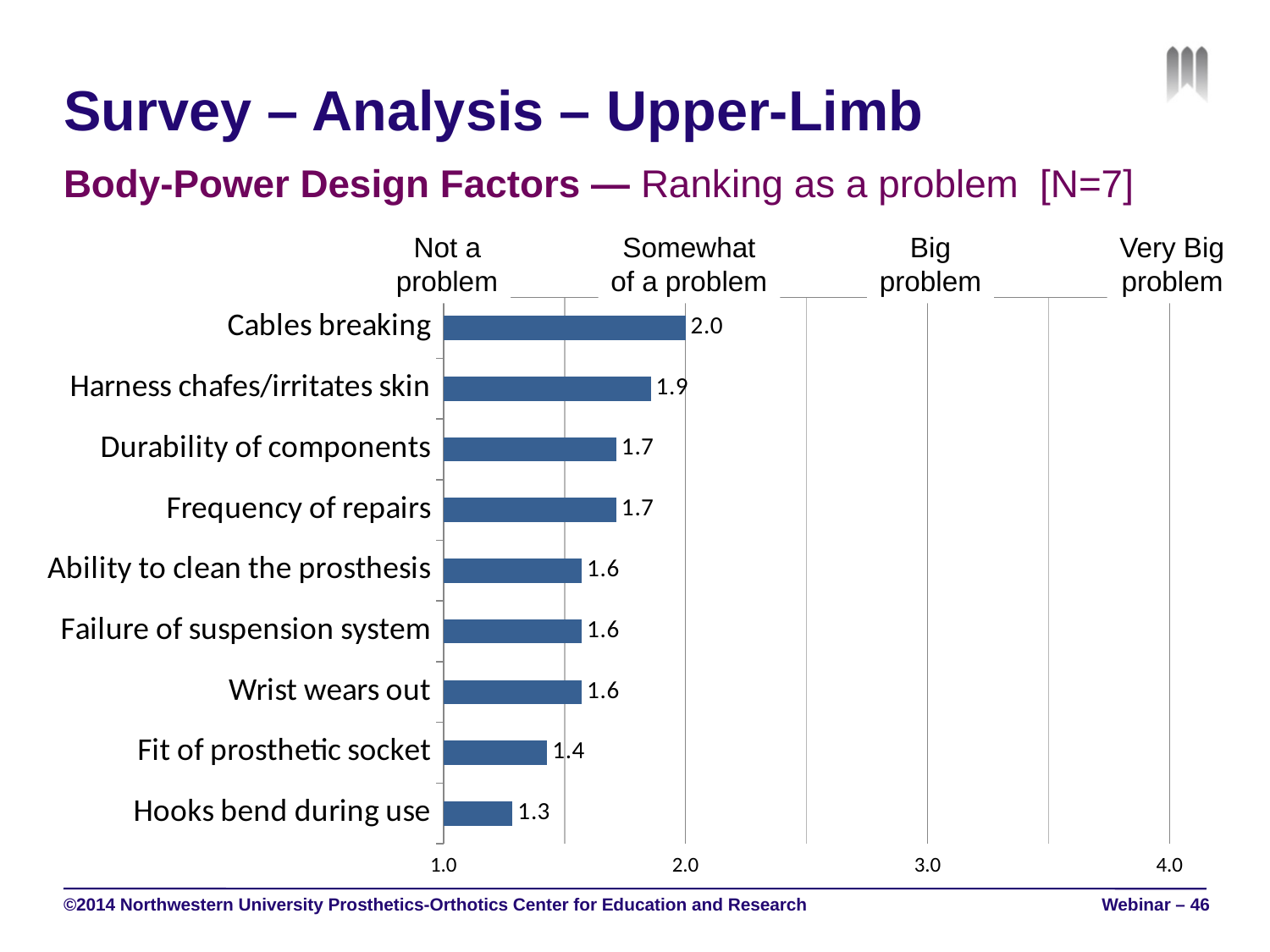
Is the value for Harness chafes/irritates skin greater or less than 2.0? less What is the value for Cables breaking? 2.0 What kind of chart is shown on the slide? bar chart What is the value for Harness chafes/irritates skin? 1.9 What is the value for Fit of prosthetic socket? 1.4 What is the difference between the values for Cables breaking and Hooks bend during use? 0.7 Which is larger, the value for Durability of components or the value for Fit of prosthetic socket? Durability of components What is the value for Hooks bend during use? 1.3 Which category has the lowest value? Hooks bend during use Which category has the highest value? Cables breaking What label appears above the 2.0 tick on the axis? Somewhat of a problem How many categories are shown in the chart? 9